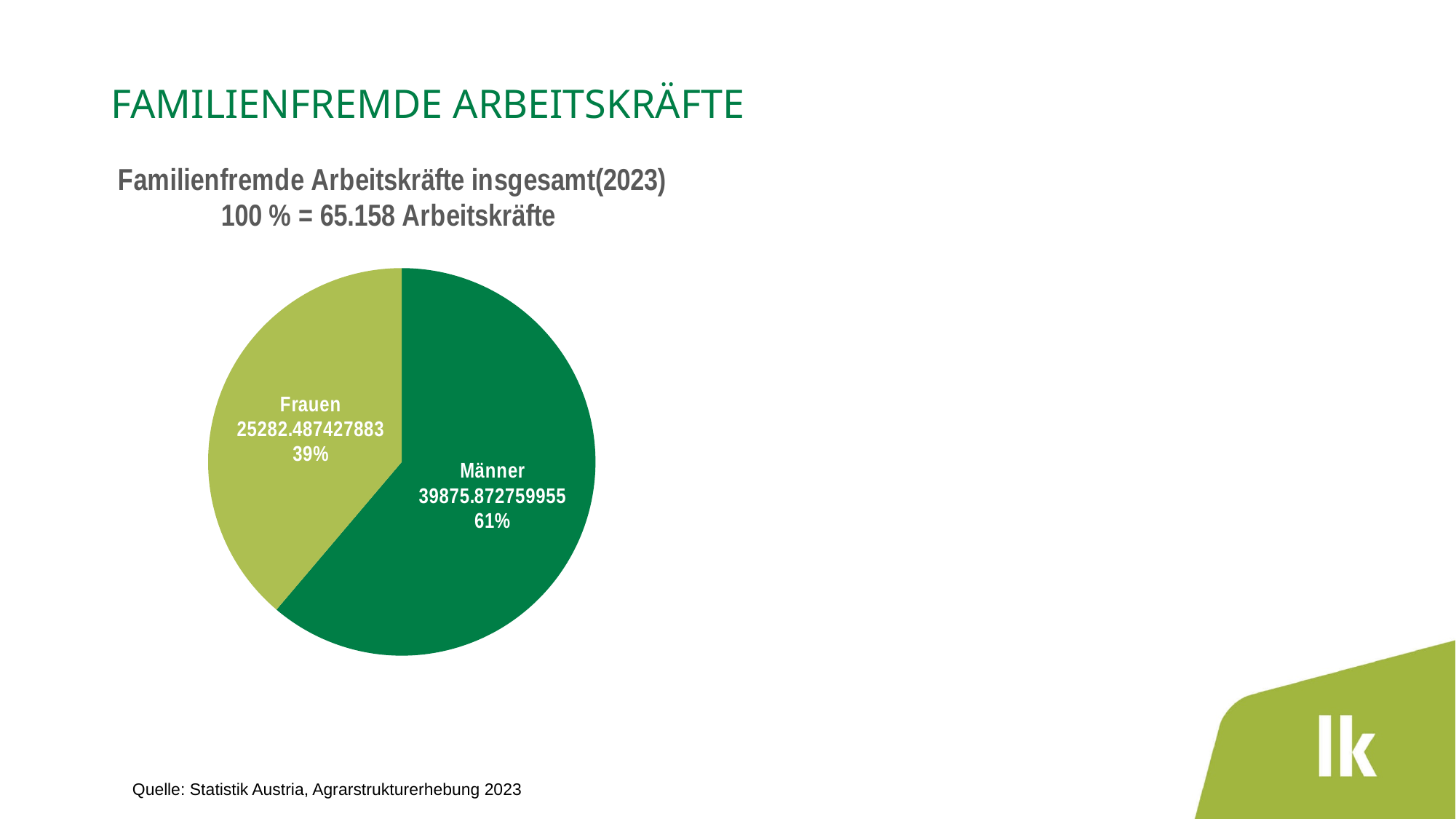
Which slice is the largest in the pie chart? Männer What value is printed on the Männer slice? 39875.872759955 What value is printed on the Frauen slice? 25282.487427883 What colour is the Frauen slice? light green Which slice is the smallest in the pie chart? Frauen How many slices does the pie chart have? 2 What kind of chart is shown on the slide? pie chart What is the difference in percentage points between the Männer share and the Frauen share? 22 percentage points What percentage share of the pie does the Männer slice represent? 61% What is the title of the chart? Familienfremde Arbeitskräfte insgesamt(2023) 100 % = 65.158 Arbeitskräfte What percentage share of the pie does the Frauen slice represent? 39% Which is larger, the Männer slice or the Frauen slice? Männer